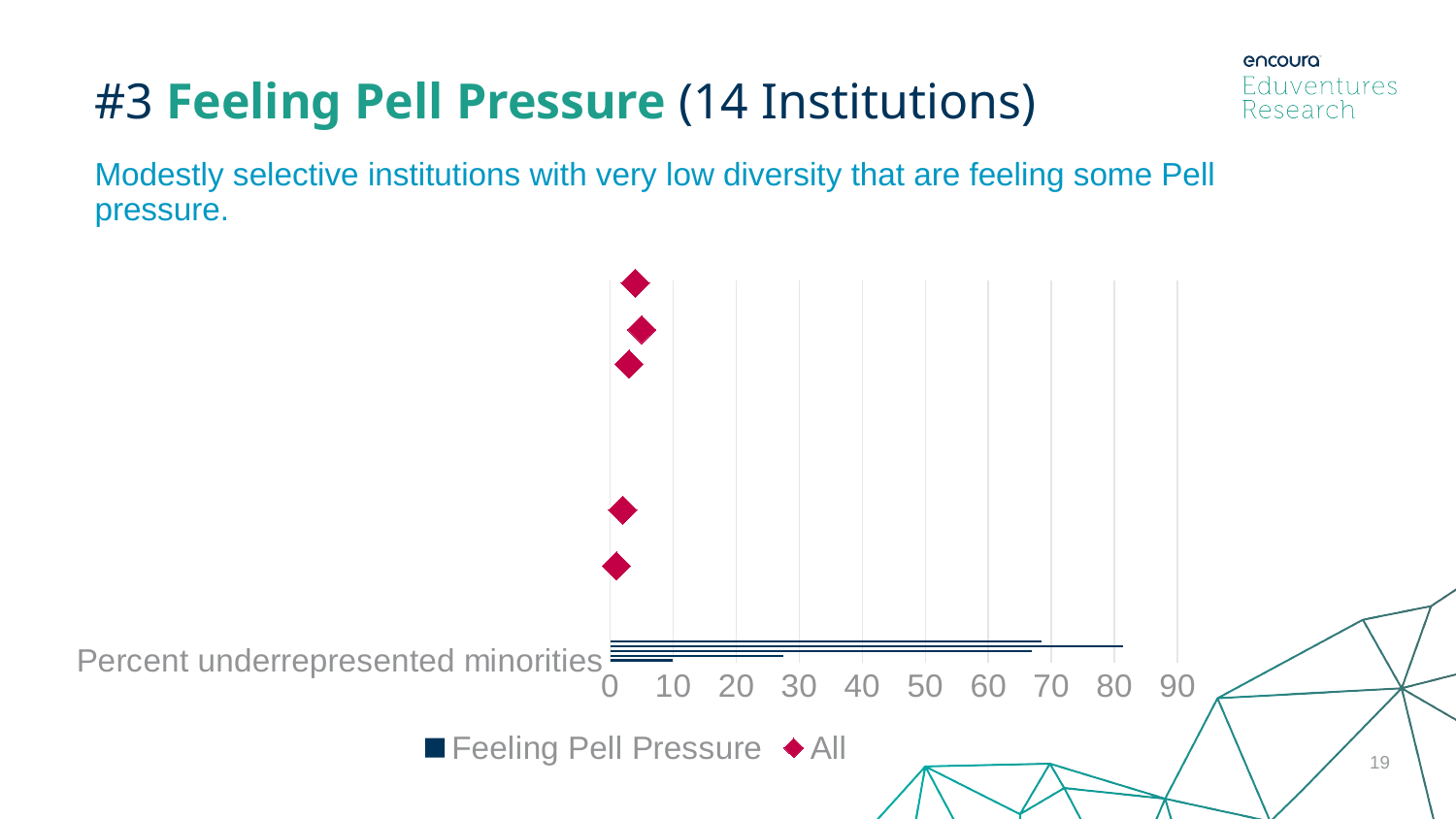
What is the interval between tick marks on the chart's horizontal axis? 10 Is the shortest Feeling Pell Pressure bar greater or less than 20? less What are the two series named in the chart legend? Feeling Pell Pressure and All What is the category label shown on the chart's vertical axis? Percent underrepresented minorities Are the All series diamond markers greater or less than 10 on the horizontal axis? less How many series does the chart legend list? 2 Is the longest Feeling Pell Pressure bar greater or less than 70? greater Which series reaches further along the horizontal axis, Feeling Pell Pressure or All? Feeling Pell Pressure